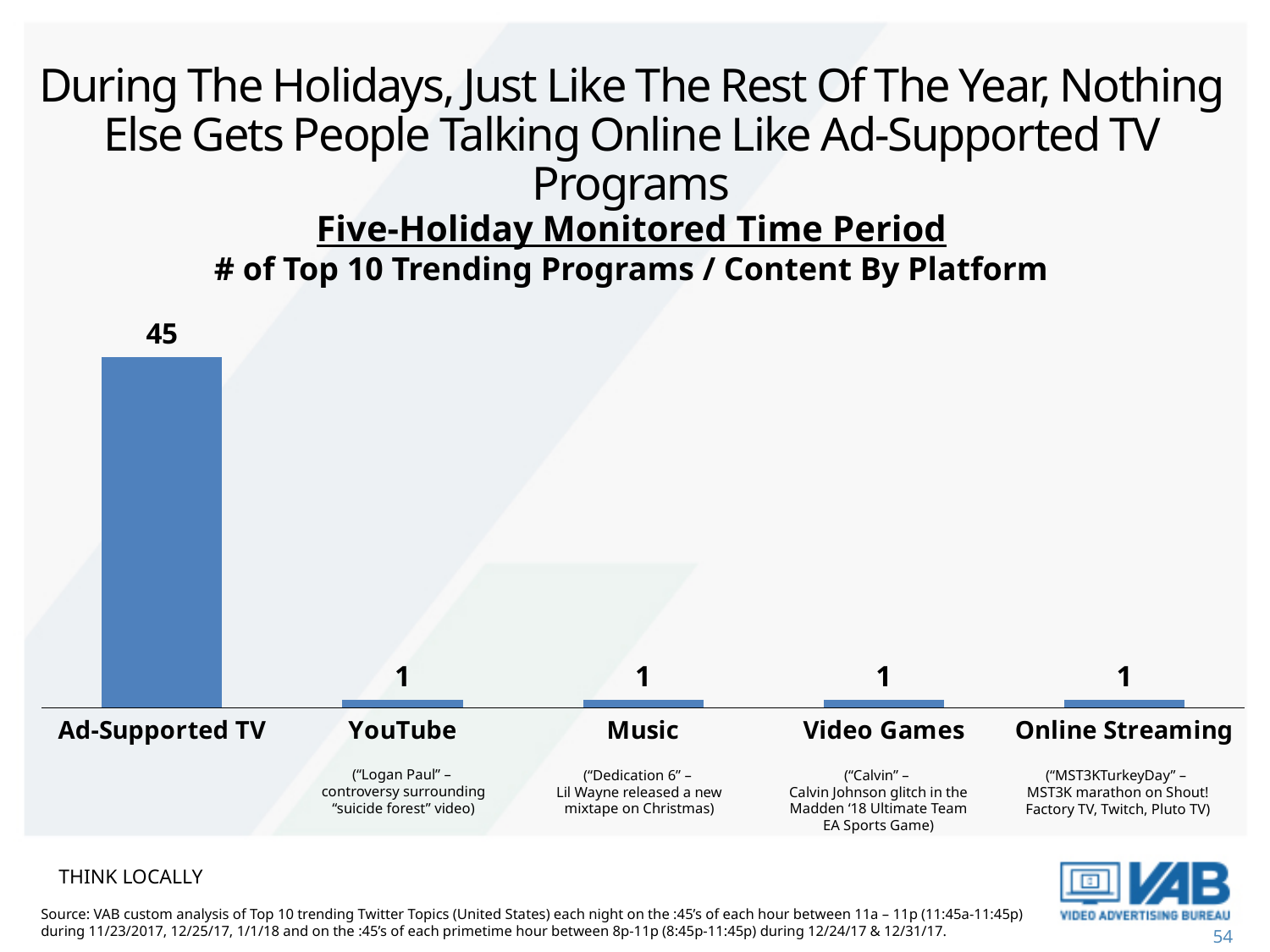
What is the value for YouTube? 1 How many categories have a value of 1? 4 What is the difference between the values for Ad-Supported TV and Music? 44 How many categories are shown in the chart? 5 What kind of chart is shown on the slide? Bar chart What is the subtitle of the chart describing what is plotted? # of Top 10 Trending Programs / Content By Platform What is the value for Online Streaming? 1 What is the total of all the values shown in the chart? 49 What time period does the chart cover, according to its heading? Five-Holiday Monitored Time Period What is the value for Ad-Supported TV? 45 Which category has the highest value? Ad-Supported TV Which is larger, the value for Ad-Supported TV or the value for Video Games? Ad-Supported TV